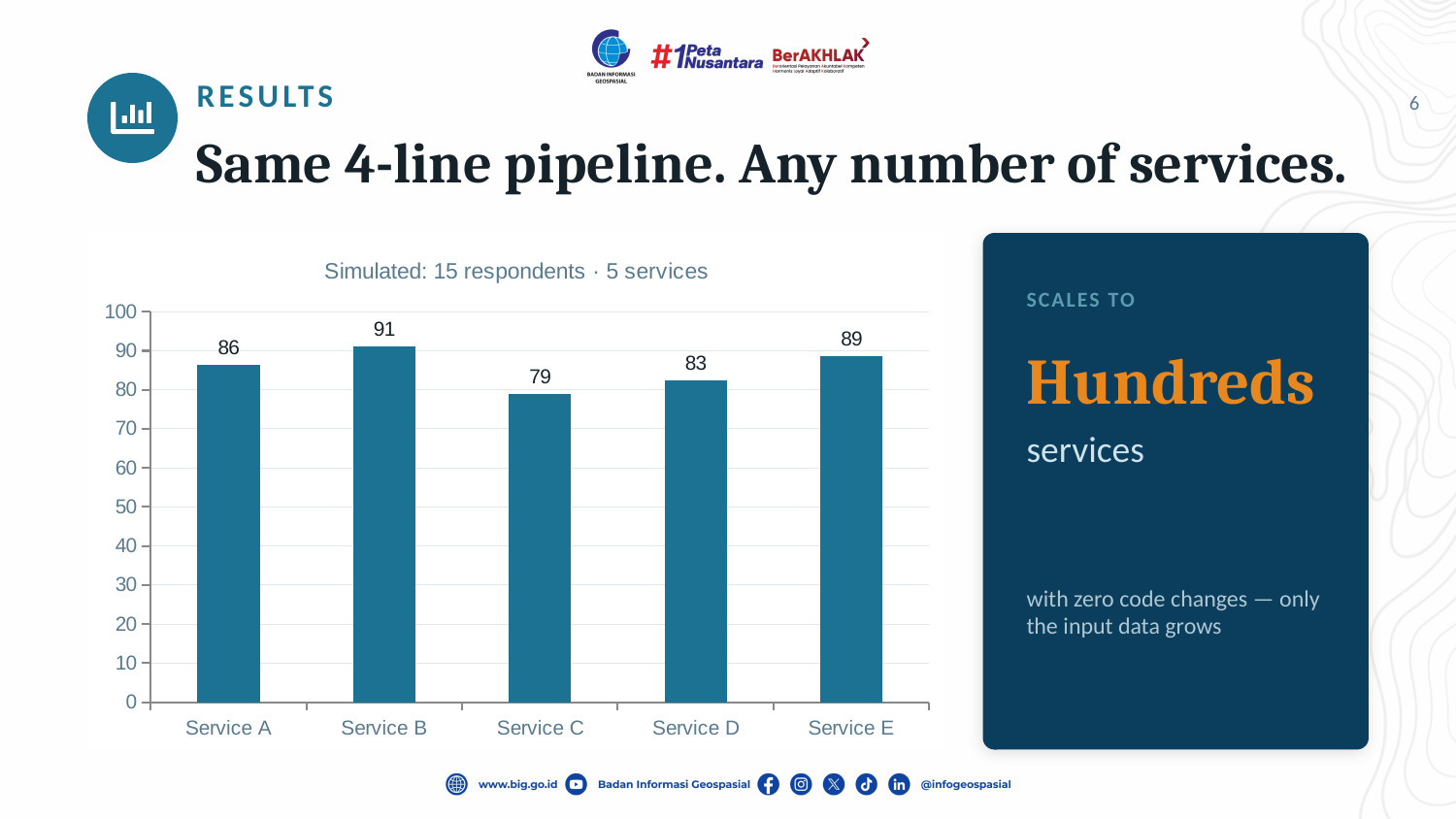
What is the value for Service C? 79 How many services are shown on the x axis? 5 What is the value for Service A? 86 What kind of chart is shown on the slide? bar chart What is the difference between the values for Service E and Service D? 6 What is the title of the chart? Simulated: 15 respondents · 5 services Which is larger, the value for Service A or the value for Service D? Service A Is the value for Service D greater or less than 90? less What is the difference between the values for Service B and Service C? 12 Which service has the lowest value? Service C What is the value for Service E? 89 Which service has the highest value? Service B